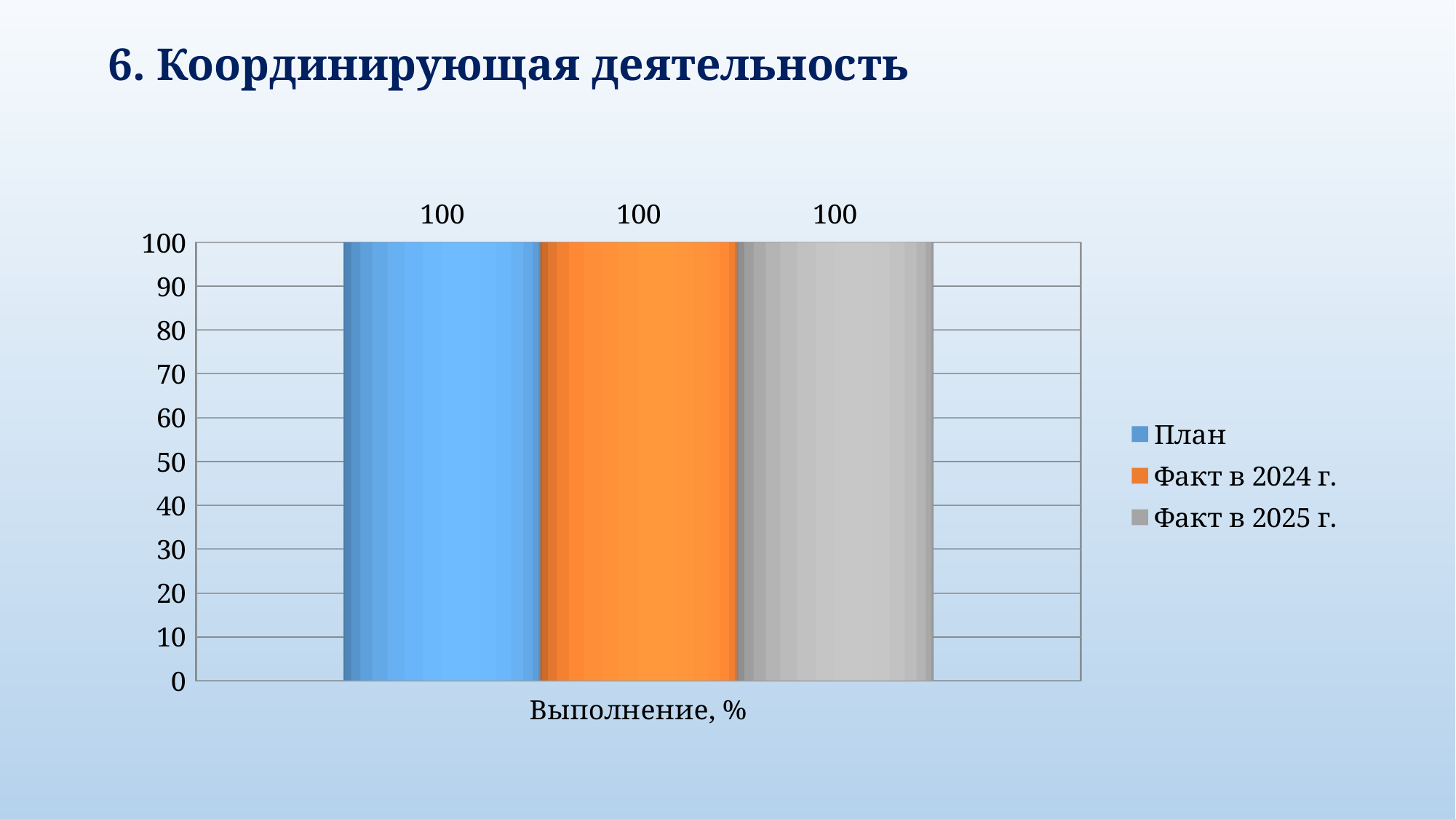
Which series is shown in orange in the legend? Факт в 2024 г. What is the value of the Факт в 2024 г. series for Выполнение, %? 100 Is the value for Факт в 2024 г. greater or less than 50? greater How many series does the legend list? 3 What is the value of the План series for Выполнение, %? 100 What is the difference between the Факт в 2024 г. value and the Факт в 2025 г. value? 0 What is the label of the category on the x axis? Выполнение, % What is the difference between the План value and the Факт в 2025 г. value? 0 What is the highest value shown on the y axis? 100 What is the value of the Факт в 2025 г. series for Выполнение, %? 100 How many categories are shown on the x axis? 1 What kind of chart is shown on the slide? Bar chart